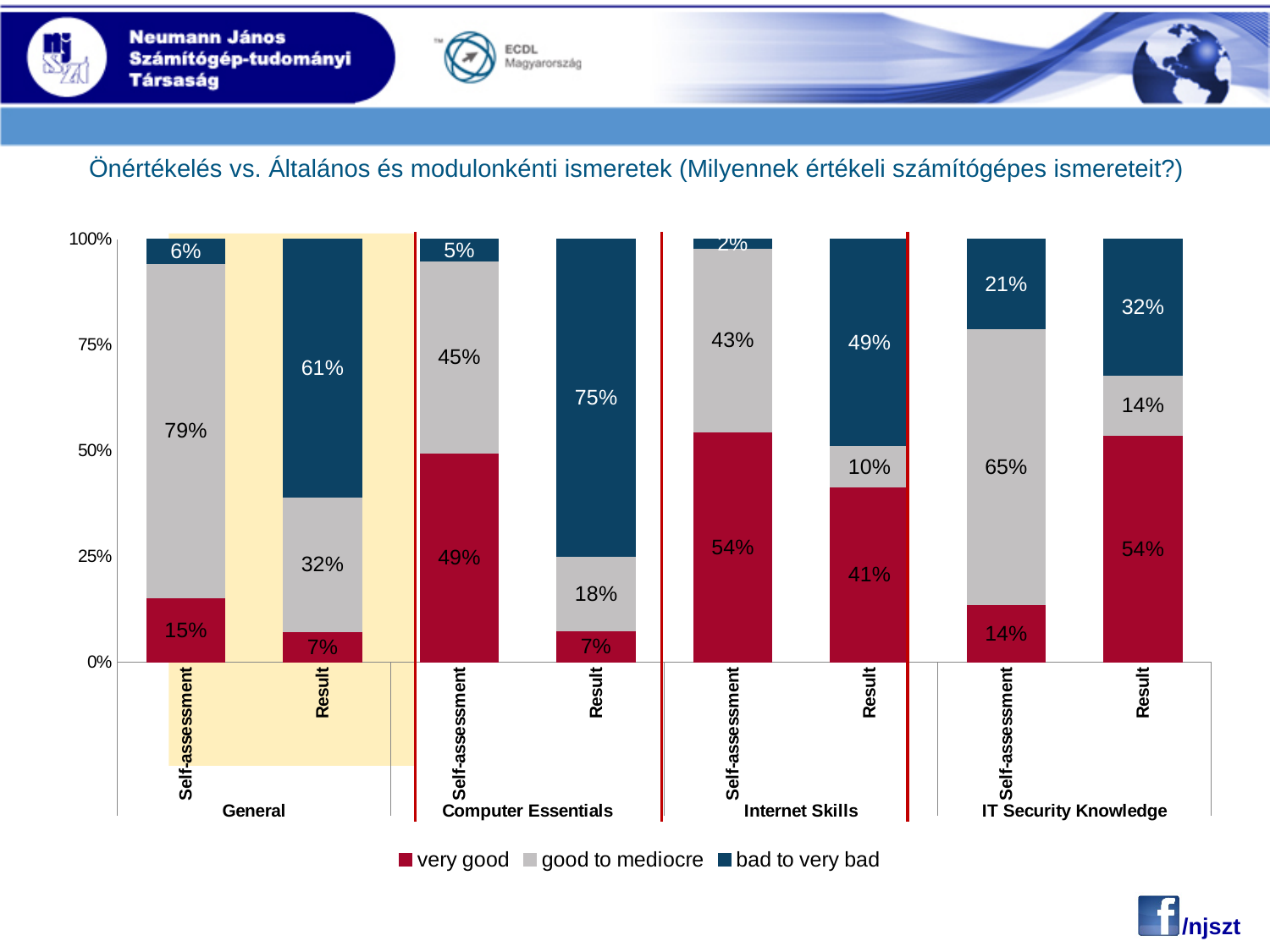
Which is larger: the 'good to mediocre' share in the IT Security Knowledge Self-assessment bar or in the IT Security Knowledge Result bar? IT Security Knowledge Self-assessment What is the difference between the 'very good' share in the Computer Essentials Self-assessment bar and the Computer Essentials Result bar? 42% Which bar has the lowest 'bad to very bad' share? Internet Skills Self-assessment How many bars are plotted in the chart? 8 How many series does the legend list? 3 Which colour represents 'very good' in the legend? Red Which bar has the highest 'bad to very bad' share? Computer Essentials Result What is the 'bad to very bad' value for the IT Security Knowledge Result bar? 32% What is the 'bad to very bad' share in the Computer Essentials Result bar? 75% What is the 'very good' value for the Internet Skills Self-assessment bar? 54% What kind of chart is shown on the slide? Stacked bar chart What percentage of the General Self-assessment bar is 'good to mediocre'? 79%